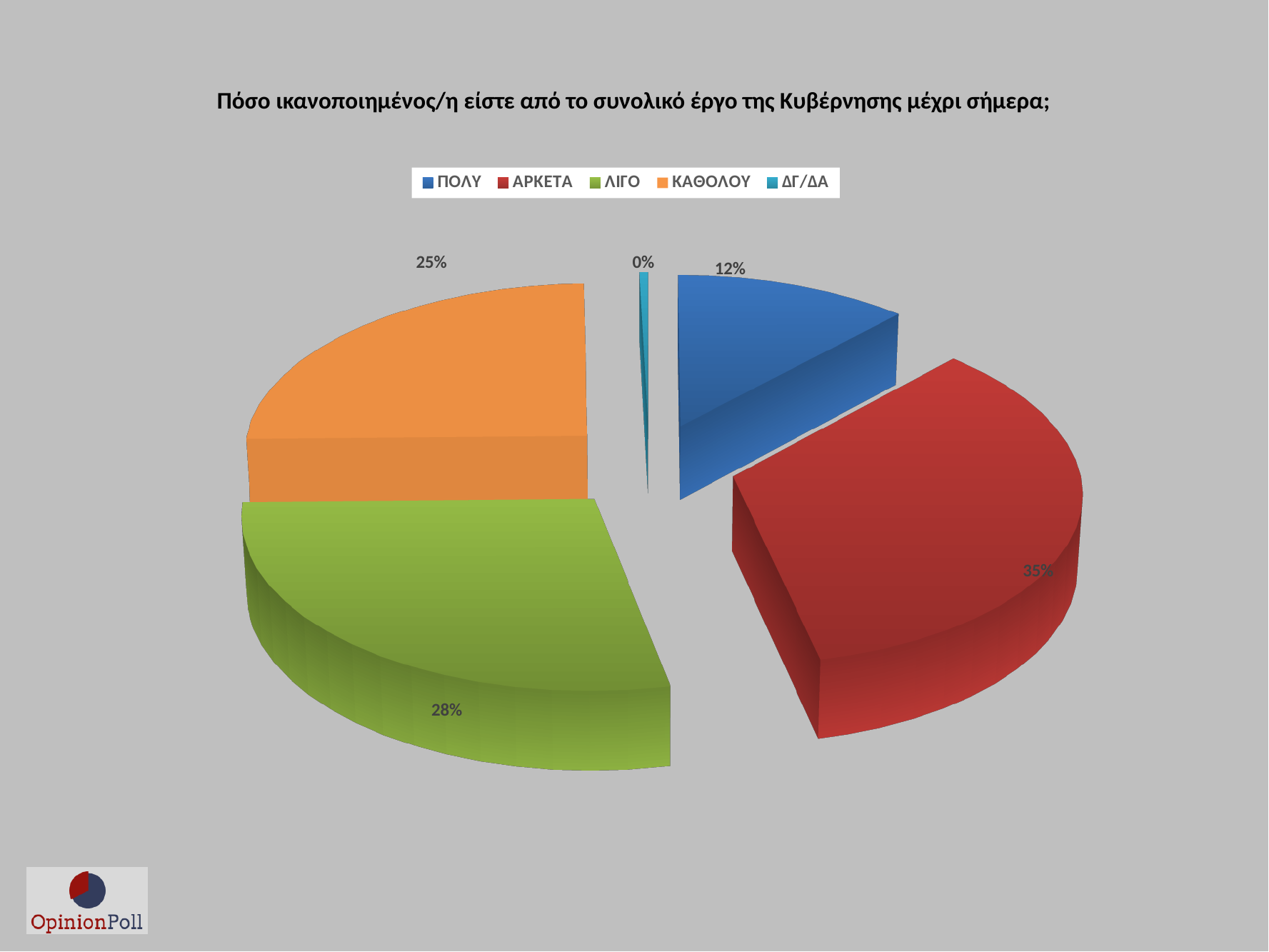
What colour is the slice for ΚΑΘΟΛΟΥ? Orange What percentage is shown for ΚΑΘΟΛΟΥ? 25% Which is larger, the share for ΛΙΓΟ or the share for ΚΑΘΟΛΟΥ? ΛΙΓΟ Which category has the largest share of the pie? ΑΡΚΕΤΑ What percentage is shown for ΛΙΓΟ? 28% Which category has the smallest share of the pie? ΔΓ/ΔΑ What percentage is shown for ΠΟΛΥ? 12% What kind of chart is shown on the slide? Pie chart What percentage is shown for ΑΡΚΕΤΑ? 35% How many categories does the legend list? 5 What percentage is shown for ΔΓ/ΔΑ? 0% What is the difference in percentage points between ΑΡΚΕΤΑ and ΠΟΛΥ? 23